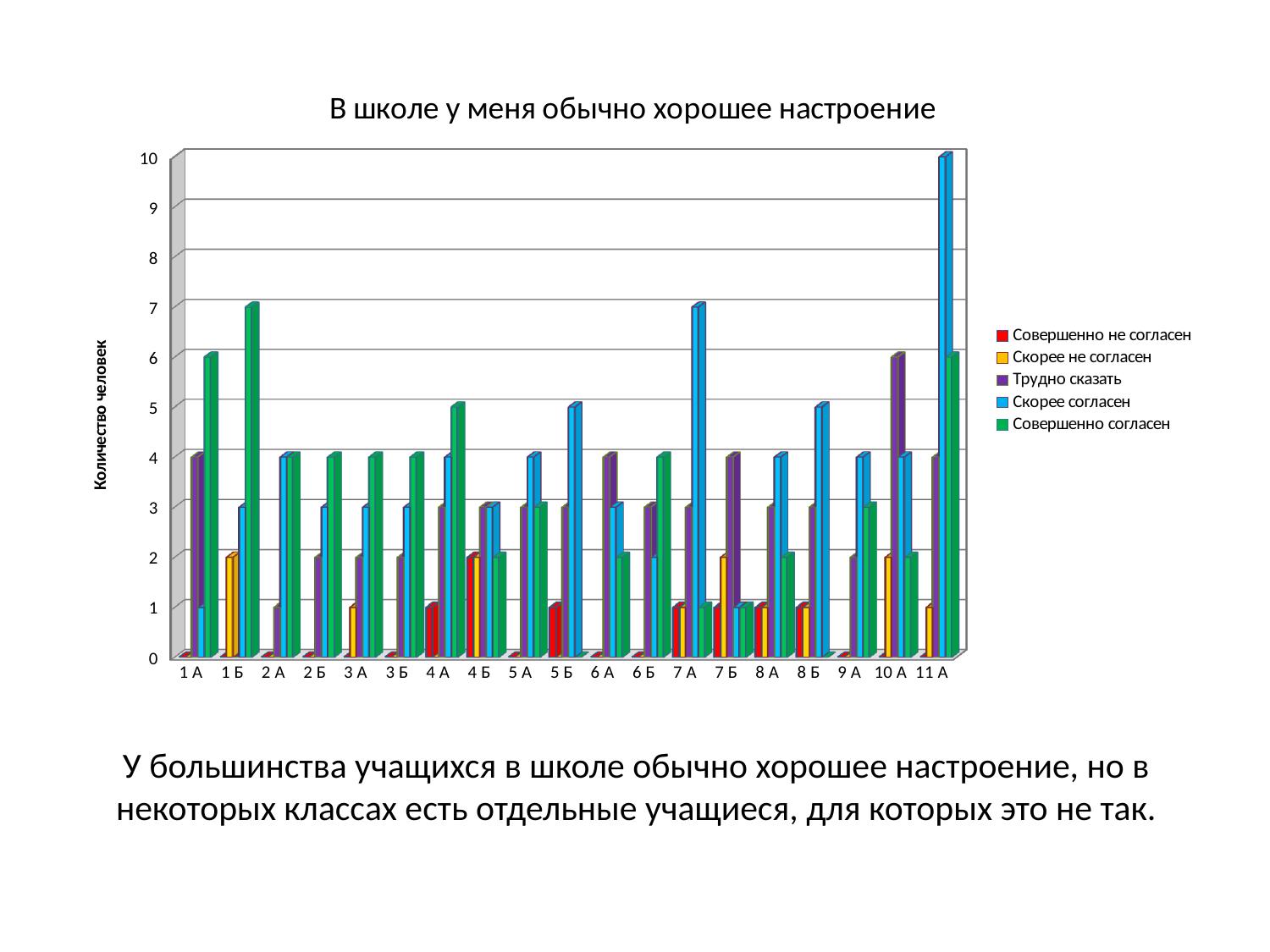
How many series does the legend list? 5 What is the label of the vertical axis? Количество человек Is the value for "Совершенно не согласен" in class 4 А greater or less than 3? less What kind of chart is shown on the slide? bar chart Which class has the highest value for the series "Скорее согласен"? 11 А Is the value for "Совершенно согласен" in class 1 Б greater or less than 5? greater What is the title of the chart? В школе у меня обычно хорошее настроение What is the value for "Скорее согласен" in class 11 А? 10 How many classes (categories) are shown on the x axis? 19 Which class has the highest value for the series "Совершенно согласен"? 1 Б Is the value for "Скорее согласен" in class 7 А greater or less than 5? greater Which is larger in class 10 А: "Трудно сказать" or "Совершенно согласен"? Трудно сказать